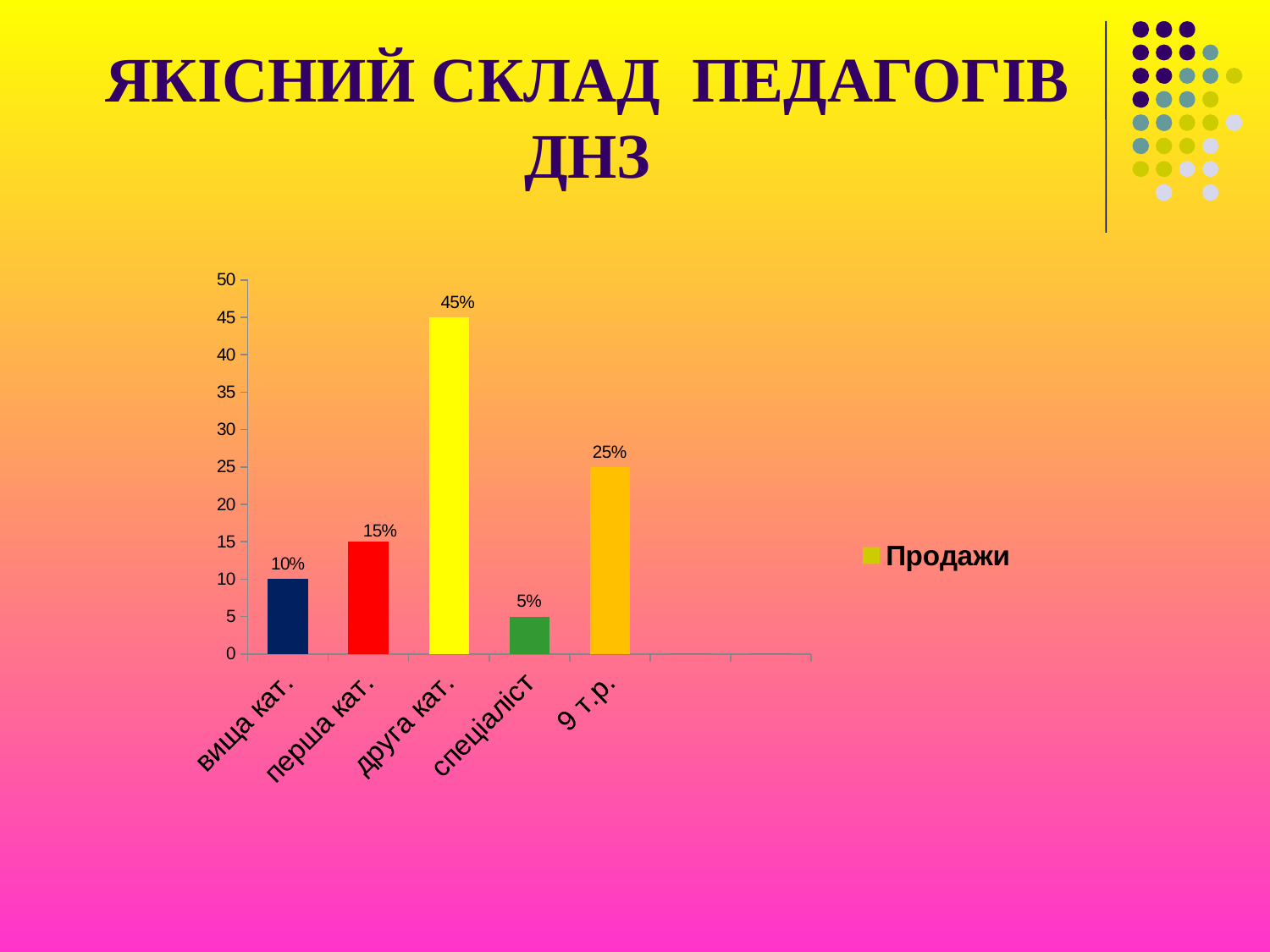
What is the value for "вища кат."? 10% Which category has the lowest value? спеціаліст How many categories are shown on the x axis? 5 What is the difference between the values for "друга кат." and "9 т.р."? 20% What is the value for "спеціаліст"? 5% How many series does the legend list? 1 What is the value for "9 т.р."? 25% What kind of chart is shown on the slide? bar chart Which is larger, the value for "перша кат." or the value for "вища кат."? перша кат. What is the value for "друга кат."? 45% What is the legend entry for the series? Продажи Which category has the highest value? друга кат.